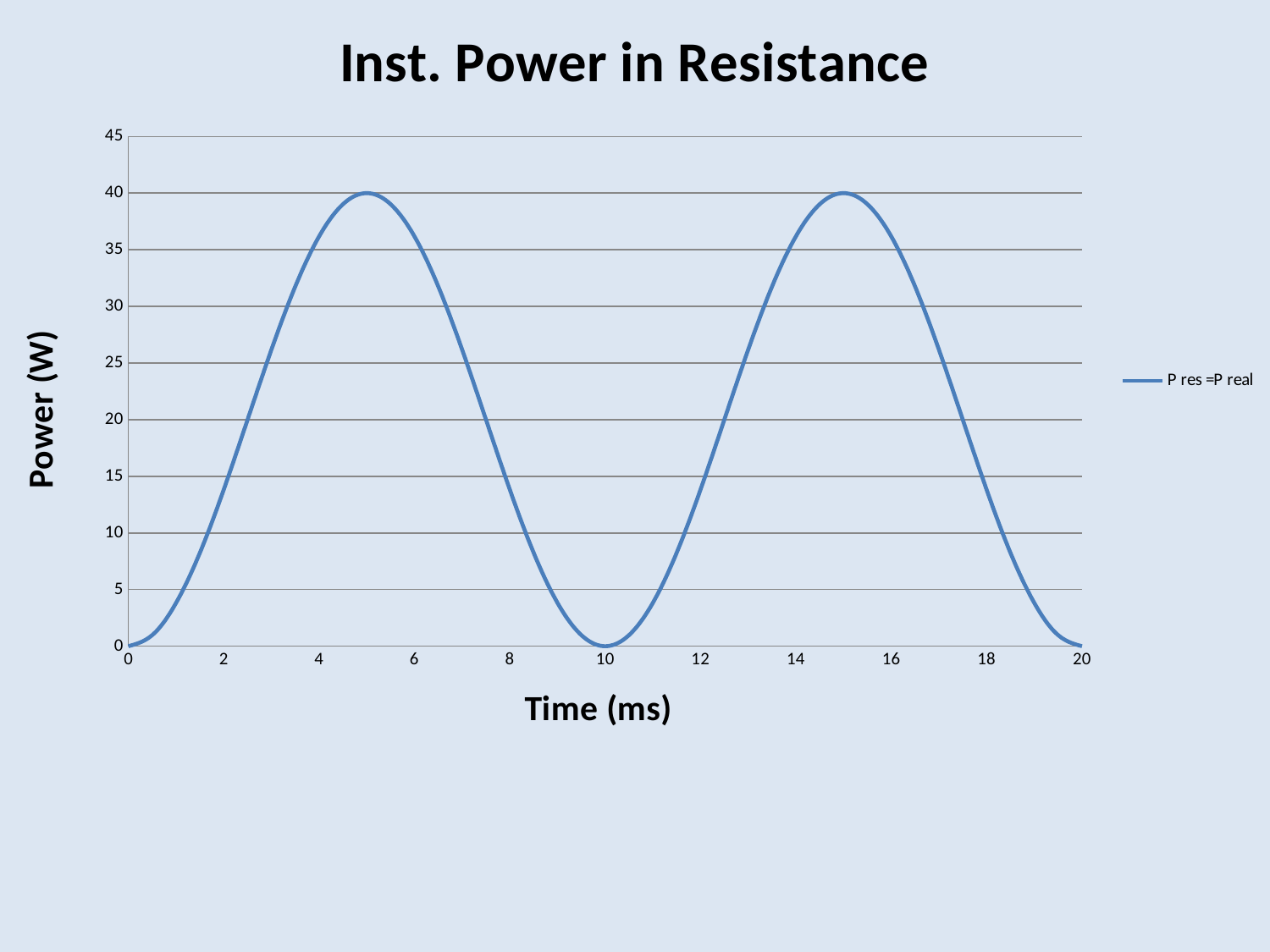
What is the minimum value of the power curve? 0 What is the name of the series shown in the legend? P res =P real Is the value of P res at time 3 ms greater or less than 20? greater How many series does the legend list? 1 What kind of chart is shown on the slide? line chart What is the value of P res at time 5 ms? 40 What is the value of P res at time 10 ms? 0 Is the value of P res at time 9 ms greater or less than 10? less What is the peak value of the power curve? 40 What is the title of the chart? Inst. Power in Resistance Which is larger, the value of P res at 5 ms or at 10 ms? 5 ms Does the power curve rise or fall between 15 ms and 20 ms? fall